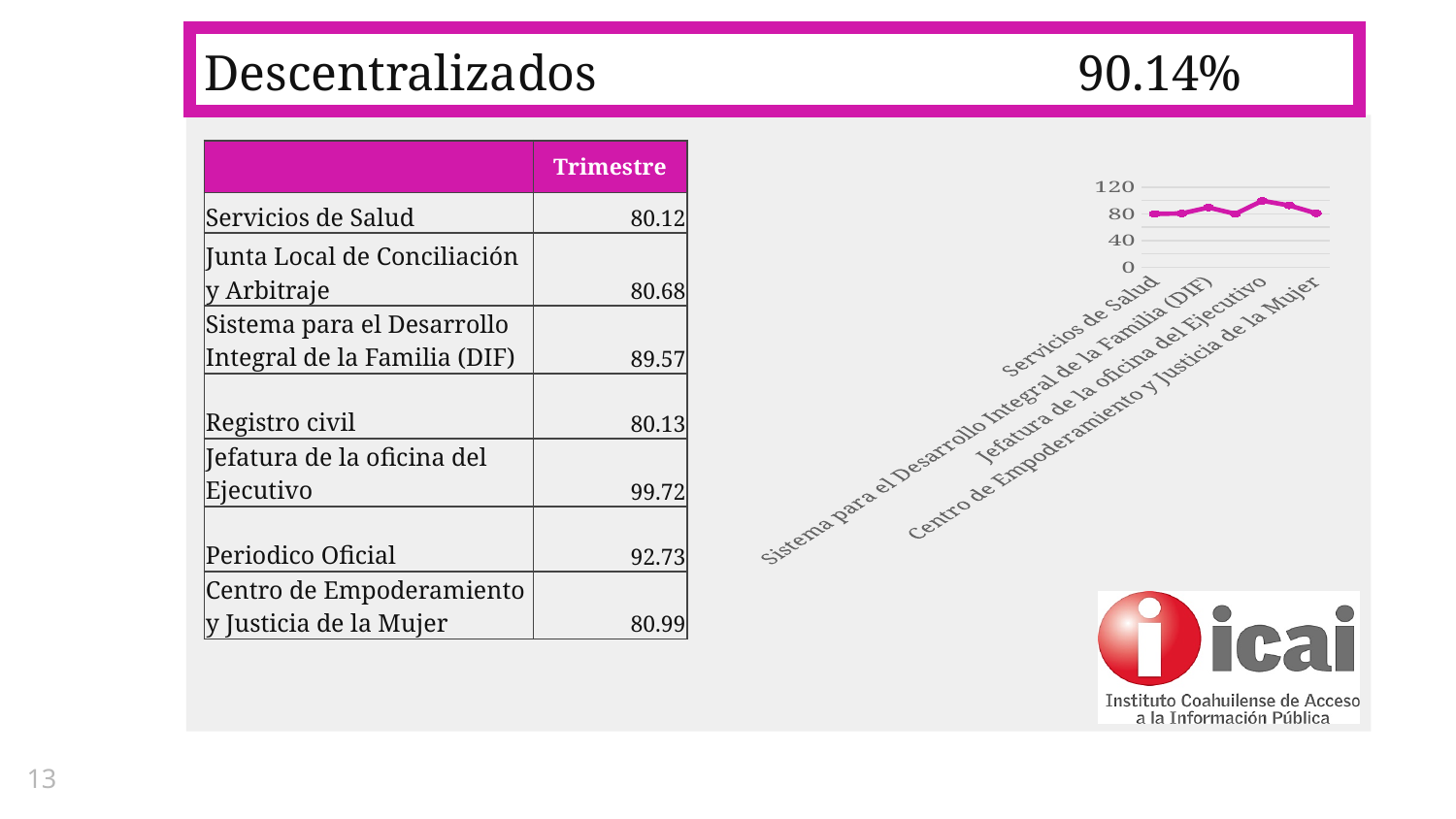
What is the Trimestre value for Sistema para el Desarrollo Integral de la Familia (DIF)? 89.57 What is the Trimestre value for Jefatura de la oficina del Ejecutivo? 99.72 Which category has the highest value on the chart? Jefatura de la oficina del Ejecutivo Is the value for Jefatura de la oficina del Ejecutivo greater or less than 80? greater What kind of chart is shown on the slide? line chart What is the difference between the values for Jefatura de la oficina del Ejecutivo and Servicios de Salud? 19.60 What is the Trimestre value for Periodico Oficial? 92.73 What colour is the line plotted on the chart? magenta Is the value for Servicios de Salud greater or less than 120? less Does the line rise or fall from Jefatura de la oficina del Ejecutivo to Centro de Empoderamiento y Justicia de la Mujer? fall How many data points are plotted on the line chart? 7 Which is larger, the value for Jefatura de la oficina del Ejecutivo or the value for Sistema para el Desarrollo Integral de la Familia (DIF)? Jefatura de la oficina del Ejecutivo